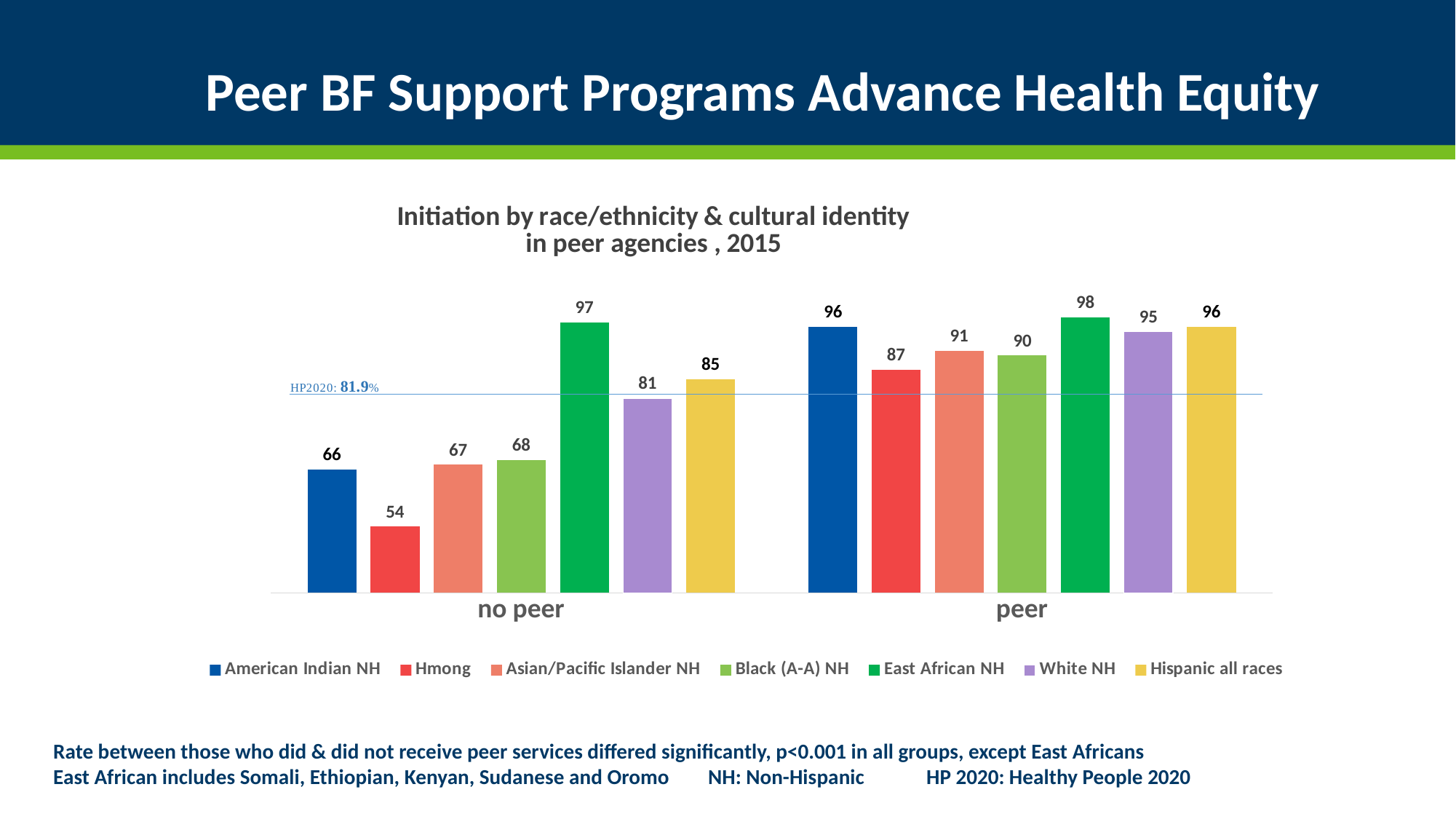
What is the HP2020 reference value marked on the chart? 81.9% What is the value for East African NH in the peer group? 98 Which series has the lowest value in the peer group? Hmong What is the difference between the peer and no peer values for Hmong? 33 What is the value for Hmong in the no peer group? 54 Which series has the lowest value in the no peer group? Hmong What is the value for White NH in the no peer group? 81 What kind of chart is shown on the slide? Bar chart Which is larger, the no peer value for Hispanic all races or the no peer value for White NH? Hispanic all races How many series does the legend list? 7 What is the difference between the peer and no peer values for American Indian NH? 30 Which series has the highest value in the no peer group? East African NH